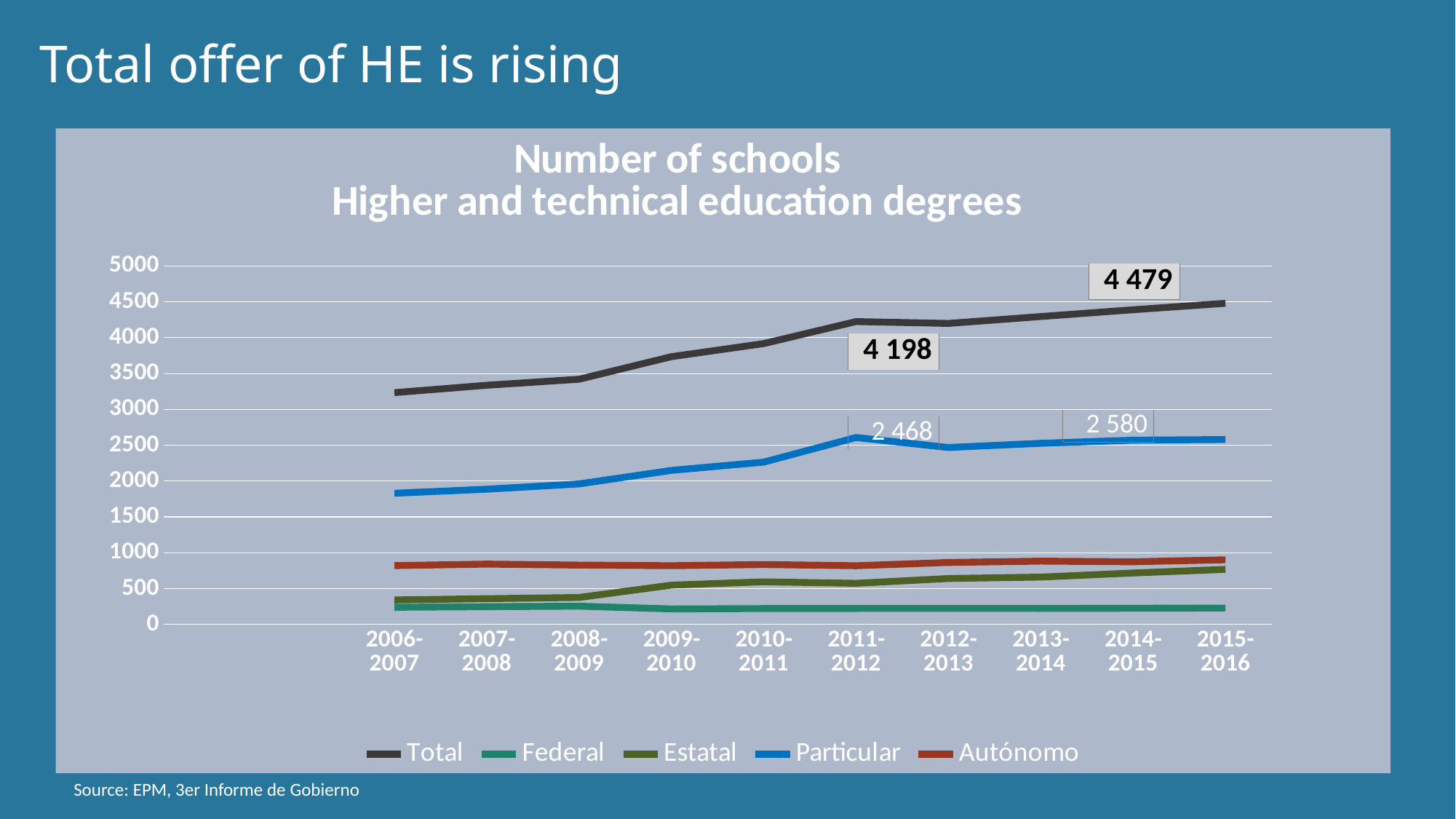
What is the value of the Particular series for 2015-2016? 2 580 How many series does the legend list? 5 What is the difference between the Total and Particular values in 2015-2016? 1 899 Which series has the lowest values across the chart? Federal How many academic years are shown on the x axis? 10 What type of chart is shown on the slide? line chart What is the value of the Total series for 2015-2016? 4 479 Does the Total series rise or fall from 2006-2007 to 2015-2016? rise Is the value of the Total series for 2006-2007 greater or less than 3000? greater